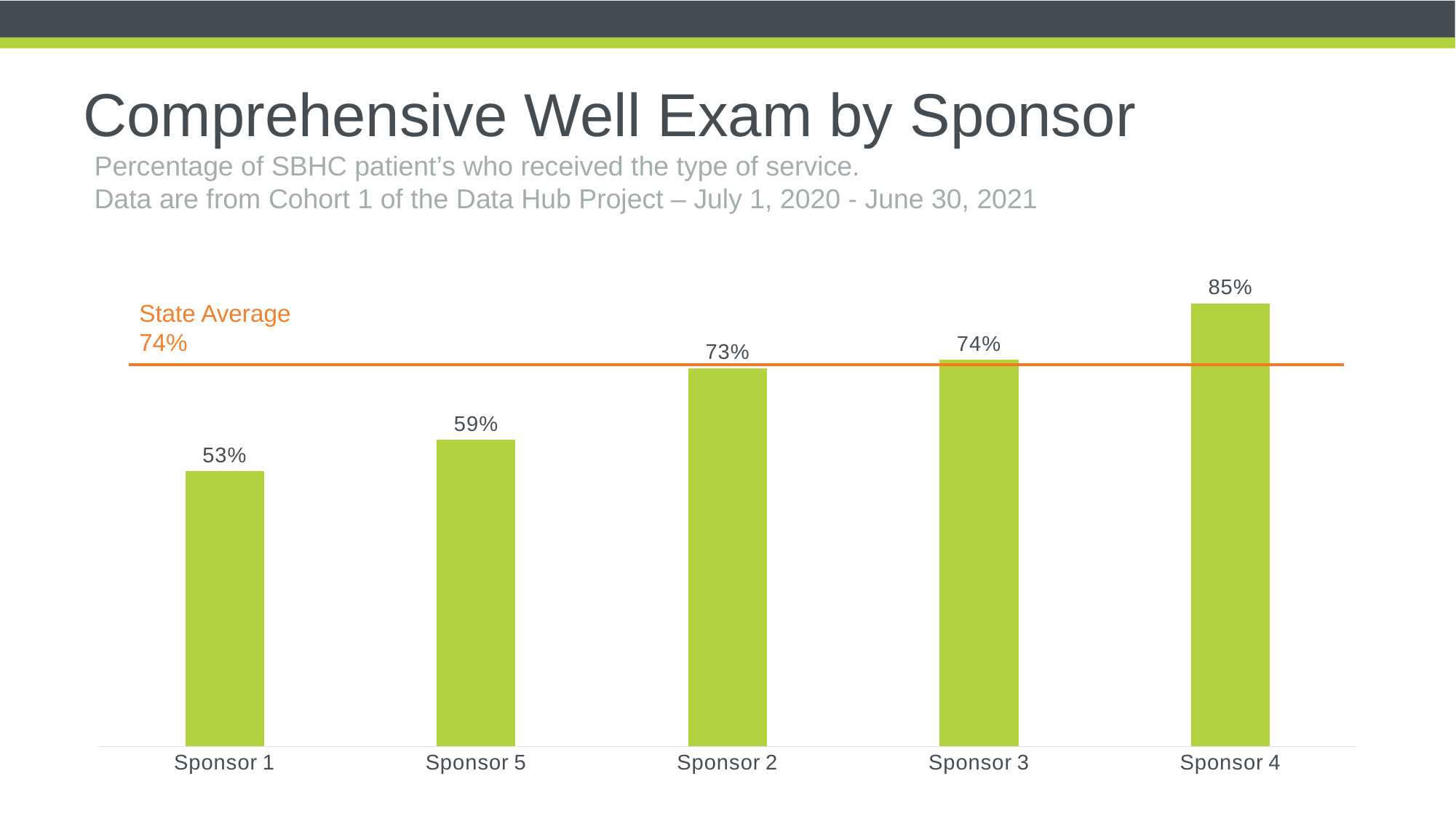
Do the values rise or fall from left to right across the sponsors? Rise What is the value for Sponsor 2? 73% Which sponsor has the highest percentage? Sponsor 4 What is the value for Sponsor 5? 59% What is the difference between the values for Sponsor 4 and Sponsor 1? 32% Which sponsor has the lowest percentage? Sponsor 1 How many sponsors are shown on the chart? 5 What is the value for Sponsor 1? 53% Which is larger, the value for Sponsor 5 or the value for Sponsor 2? Sponsor 2 What is the value for Sponsor 4? 85% What is the State Average shown by the orange line on the chart? 74% What kind of chart is shown on the slide? Bar chart